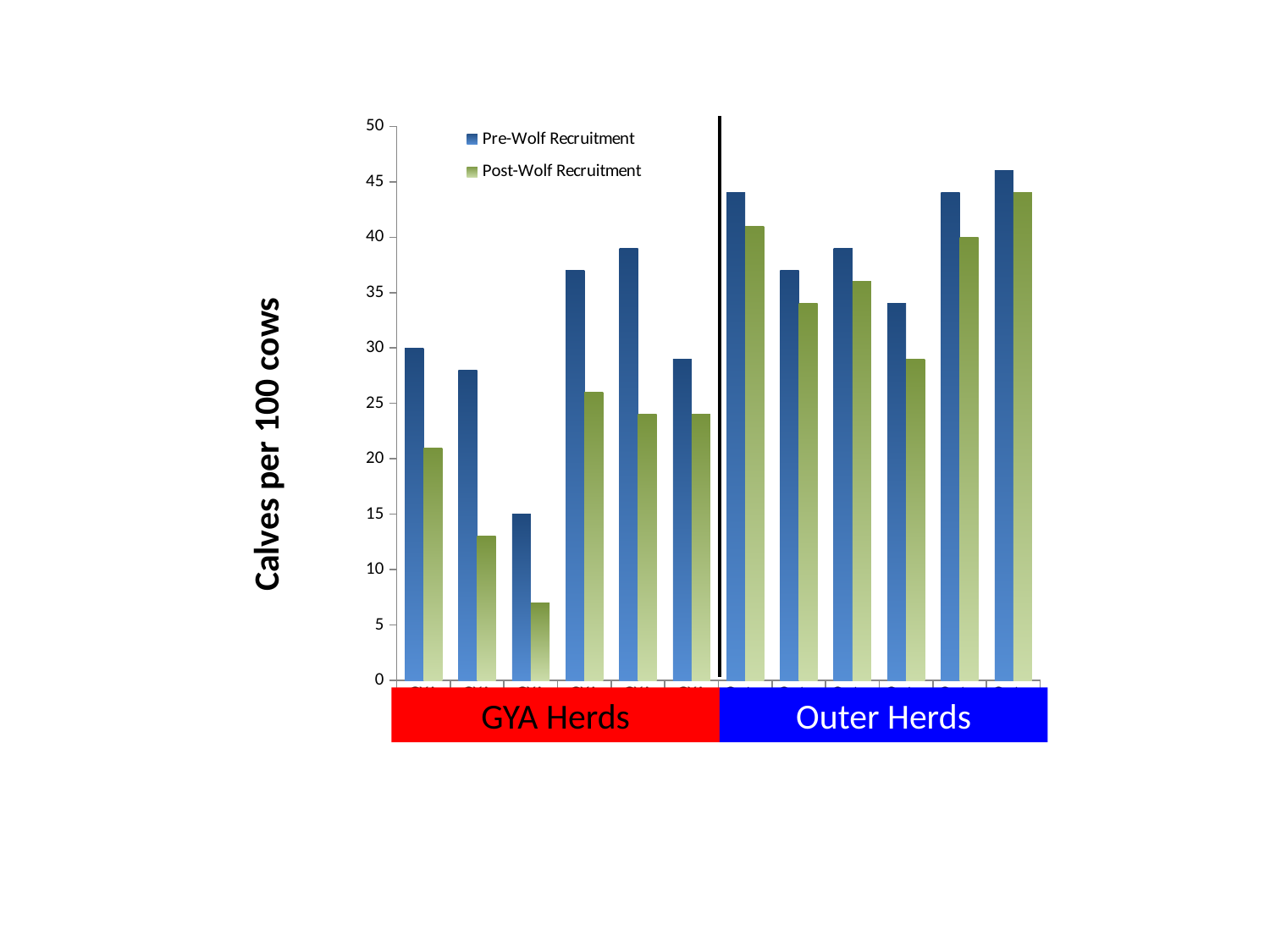
Which herd group has the lowest Post-Wolf Recruitment value? the third GYA herd from the left What is the label on the vertical axis? Calves per 100 cows For the third GYA herd from the left, which is larger: the Pre-Wolf Recruitment or the Post-Wolf Recruitment value? Pre-Wolf Recruitment What kind of chart is shown on the slide? bar chart How many herd groups (pairs of bars) are plotted in total? 12 Is the Pre-Wolf Recruitment value for the rightmost Outer herd greater or less than 40? greater Is the Post-Wolf Recruitment value for the third GYA herd from the left greater or less than 10? less How many herd groups are in the GYA Herds section? 6 Is the Post-Wolf Recruitment value for the first Outer herd (just right of the black divider) greater or less than 35? greater How many series does the legend list? 2 What are the two series named in the legend? Pre-Wolf Recruitment and Post-Wolf Recruitment